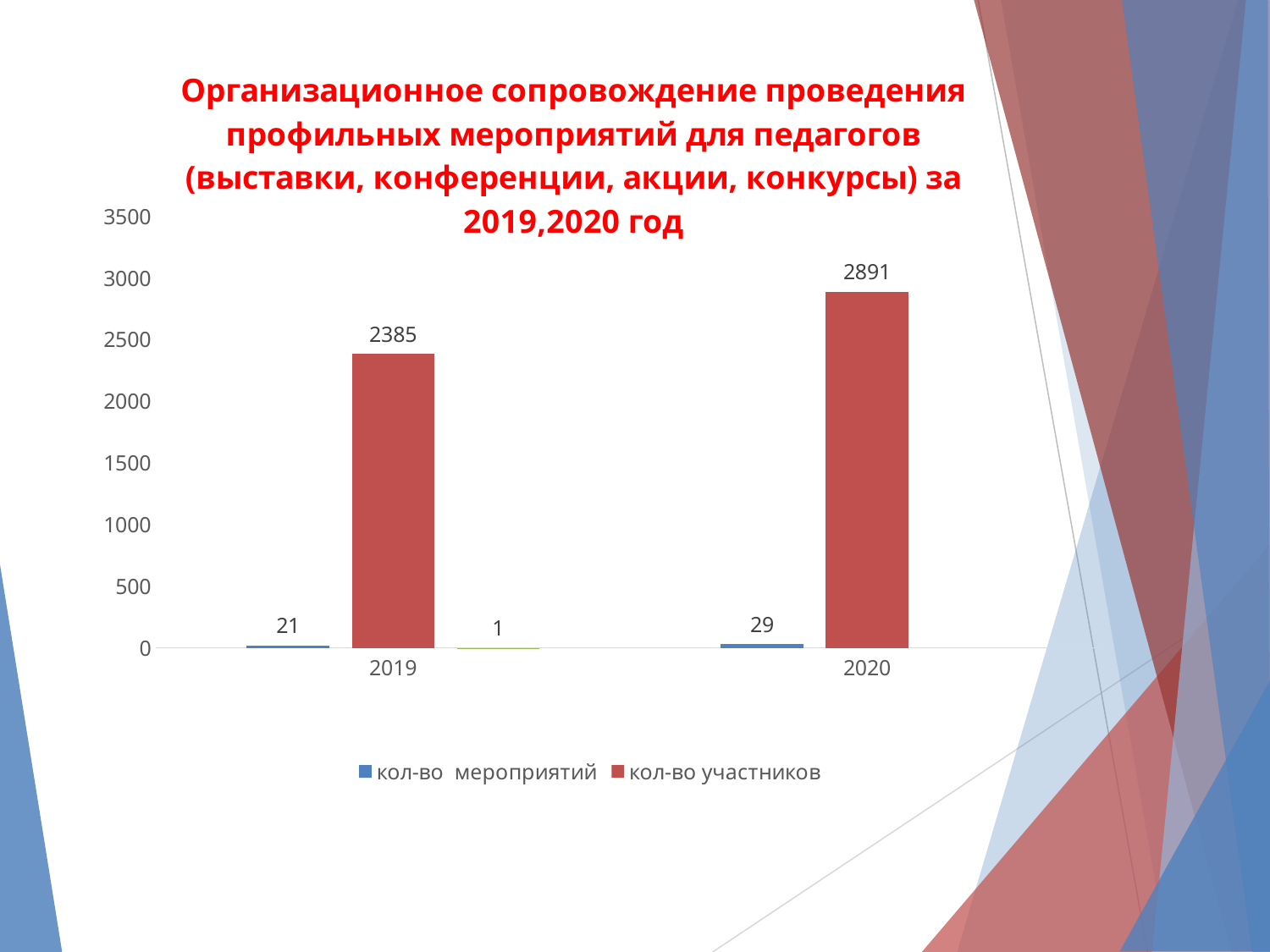
Does кол-во участников rise or fall from 2019 to 2020? rise What is the value for кол-во участников in 2019? 2385 What is the difference between кол-во участников in 2020 and in 2019? 506 In which year is кол-во участников highest? 2020 In which year is кол-во мероприятий lowest? 2019 What is the value for кол-во мероприятий in 2019? 21 How many series does the legend list? 2 Which is larger: кол-во участников in 2019 or кол-во участников in 2020? 2020 What is the value for кол-во участников in 2020? 2891 What is the difference between кол-во мероприятий in 2020 and in 2019? 8 What kind of chart is shown on the slide? bar chart What is the value for кол-во мероприятий in 2020? 29